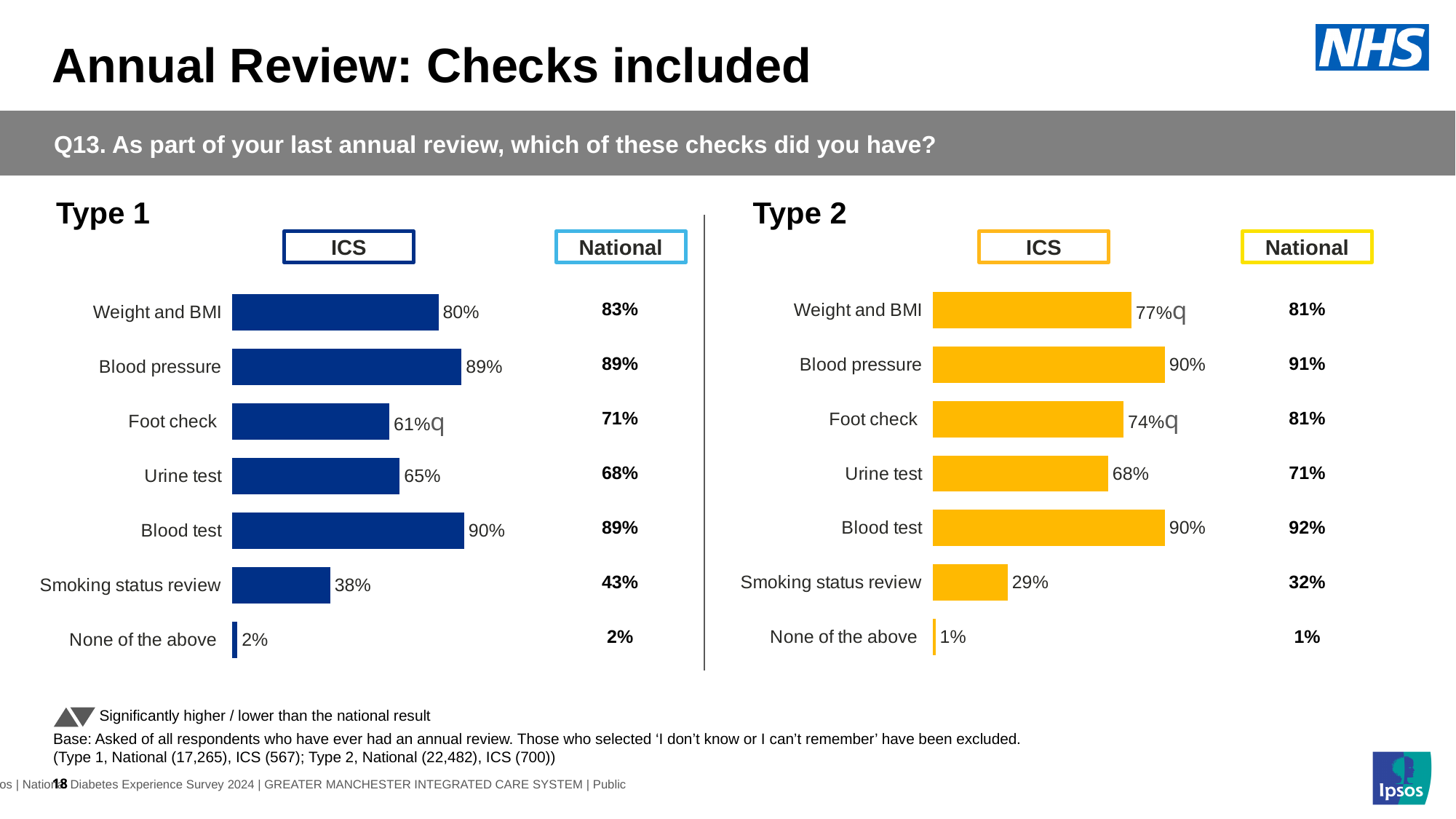
In the Type 1 chart, what is the ICS value for Foot check? 61% In the Type 2 chart, what is the National value for Blood test? 92% What colour are the ICS bars in the Type 2 chart? Yellow In the Type 1 chart, what is the difference between the ICS values for Blood pressure and Smoking status review? 51% In the Type 2 chart, what is the ICS value for Smoking status review? 29% In the Type 2 chart, what is the difference between the National and ICS values for Foot check? 7% In the Type 1 chart, which is larger for Weight and BMI: the ICS value or the National value? National In the Type 1 chart, what is the National value for Urine test? 68% In the Type 2 chart, which check has the lowest ICS value? None of the above What type of chart is used for the Type 1 ICS results? Bar chart How many checks are listed in the Type 2 chart? 7 In the Type 1 chart, which check has the highest ICS value? Blood test